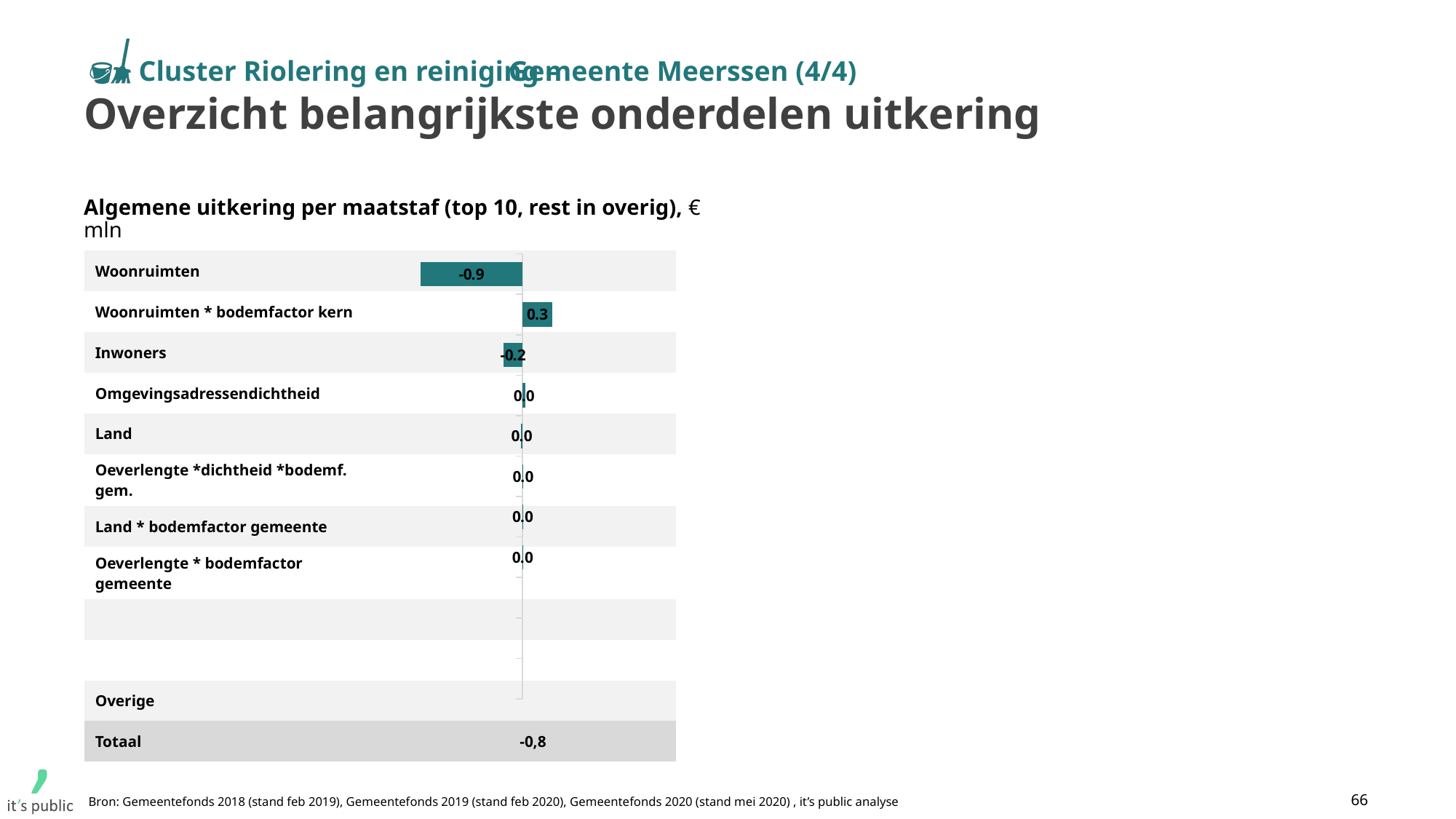
What is the difference between the values for Woonruimten * bodemfactor kern and Woonruimten? 1.2 What type of chart is shown on the slide? Bar chart What is the value for Inwoners? -0.2 What is the value for Woonruimten * bodemfactor kern? 0.3 What is the value for Land? 0.0 Which is larger, the value for Inwoners or the value for Woonruimten? Inwoners How many categories show a value of 0.0? 5 What is the value shown for Totaal? -0,8 What is the value for Woonruimten? -0.9 Which category has the highest value? Woonruimten * bodemfactor kern What is the title of the chart? Algemene uitkering per maatstaf (top 10, rest in overig), € mln Which category has the lowest (most negative) value? Woonruimten